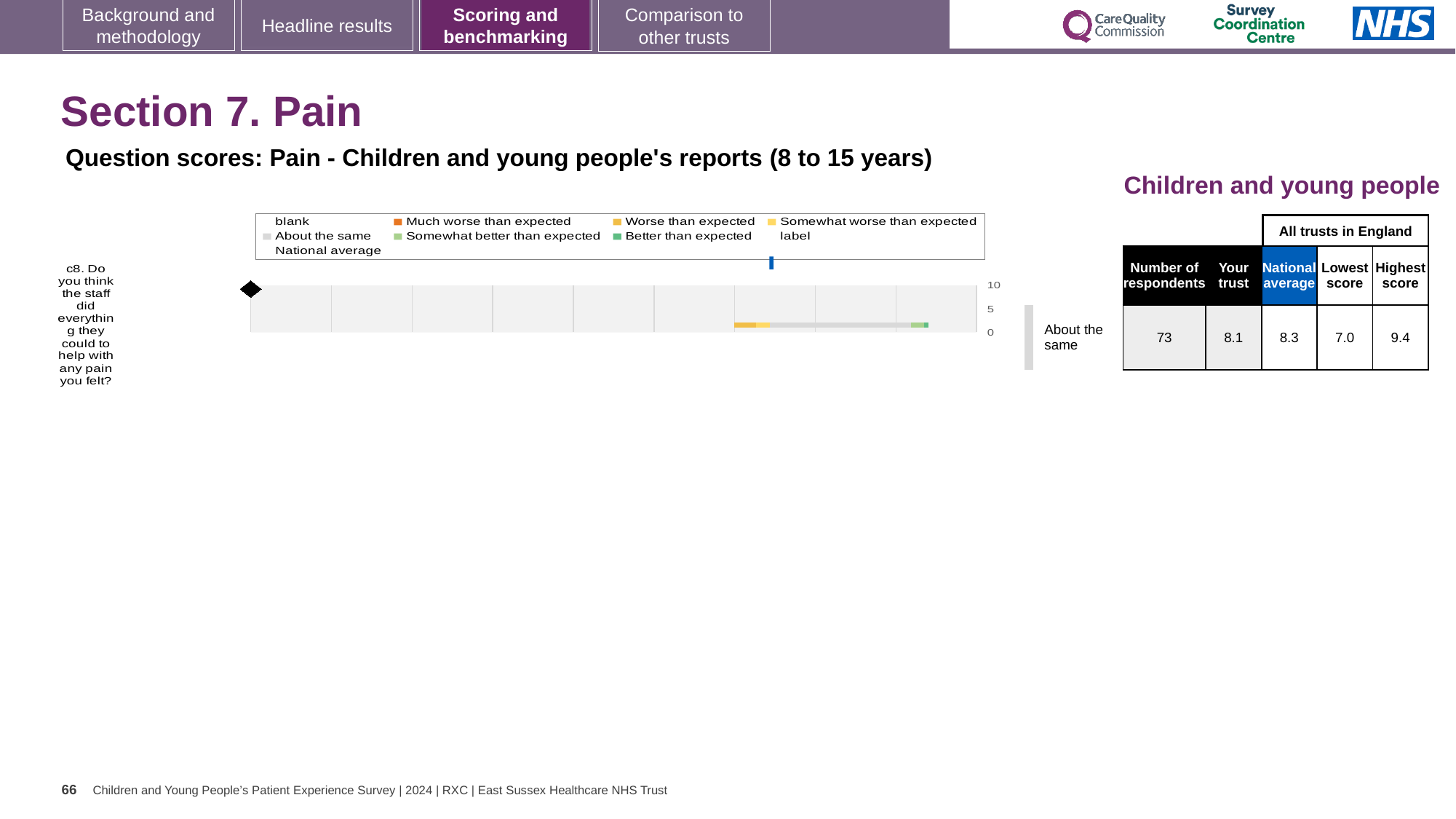
Which is larger for question c8, the 'Your trust' score or the national average? National average In the table beside the chart, how many respondents answered question c8? 73 How many questions (categories) are plotted on the chart? 1 In the table beside the chart, what is the 'Your trust' score for question c8? 8.1 What kind of chart is shown on the slide? bar chart Which question is plotted on the chart? c8. Do you think the staff did everything they could to help with any pain you felt? What is the highest value shown on the chart's axis? 10 What is the difference between the highest score and the lowest score for question c8 in the table? 2.4 In the table beside the chart, what is the lowest score among all trusts in England for question c8? 7.0 What rating is given next to the chart for question c8? About the same In the table beside the chart, what is the highest score among all trusts in England for question c8? 9.4 In the table beside the chart, what is the national average score for question c8? 8.3